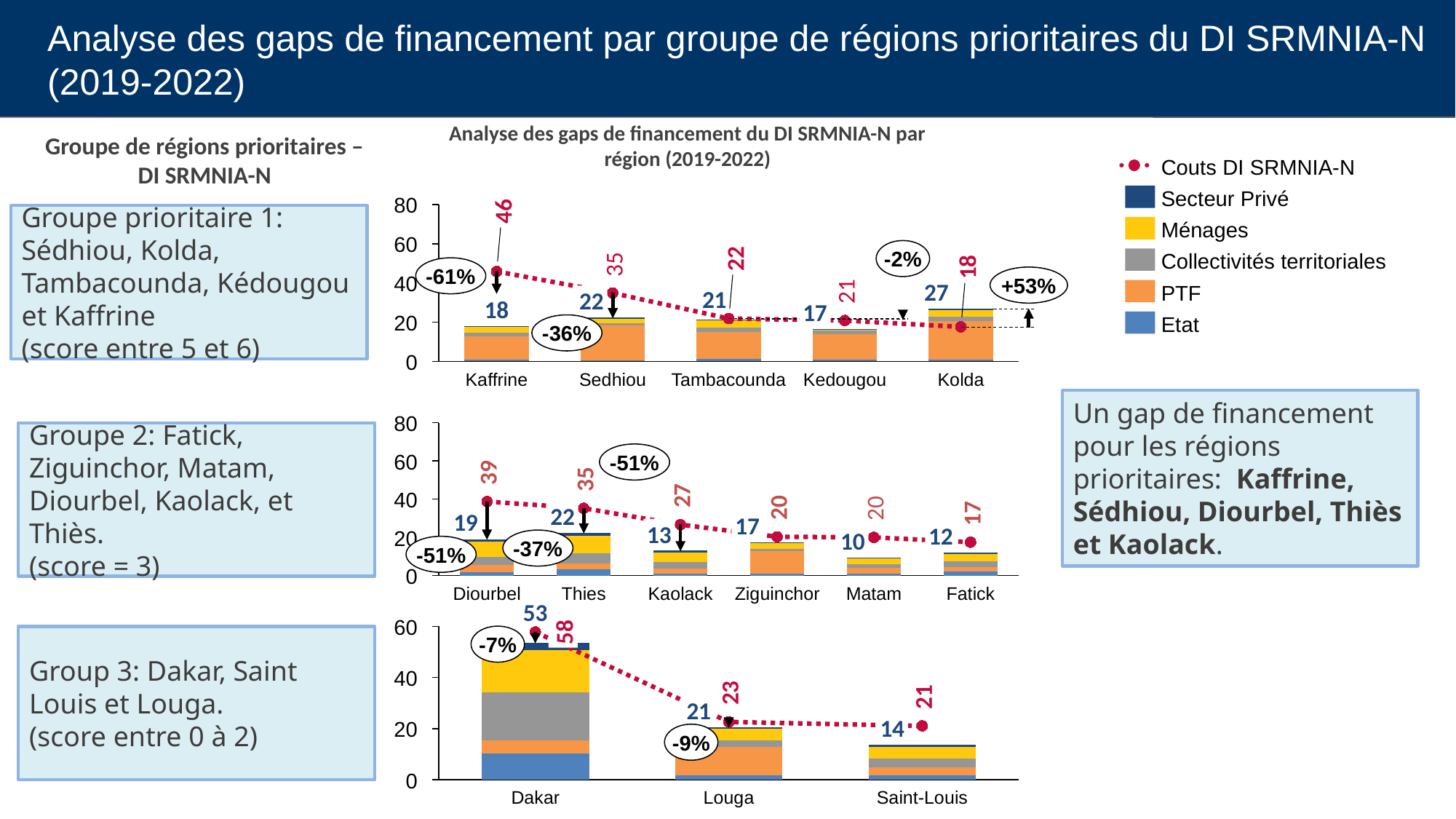
How many entries does the legend on the right of the slide list? 6 In the top chart (Kaffrine to Kolda), what is the difference between the Couts DI SRMNIA-N value and the total financing for Sedhiou? 13 In the top chart (Kaffrine to Kolda), which region has the highest Couts DI SRMNIA-N value? Kaffrine In the middle chart (Diourbel to Fatick), how many regions are shown on the x axis? 6 In the middle chart (Diourbel to Fatick), what is the total financing (blue label) for Matam? 10 In the top chart (Kaffrine to Kolda), what is the Couts DI SRMNIA-N value for Kaffrine? 46 In the top chart (Kaffrine to Kolda), what is the total financing (blue label) for Kolda? 27 In the bottom chart (Dakar, Louga, Saint-Louis), which is larger: the total financing for Louga or for Saint-Louis? Louga In the bottom chart (Dakar, Louga, Saint-Louis), what is the difference between the Couts DI SRMNIA-N value and the total financing for Saint-Louis? 7 In the middle chart (Diourbel to Fatick), does the Couts DI SRMNIA-N line rise or fall from Diourbel to Fatick? fall In the bottom chart (Dakar, Louga, Saint-Louis), what is the Couts DI SRMNIA-N value for Dakar? 58 In the middle chart (Diourbel to Fatick), which region has the lowest total financing (blue label)? Matam